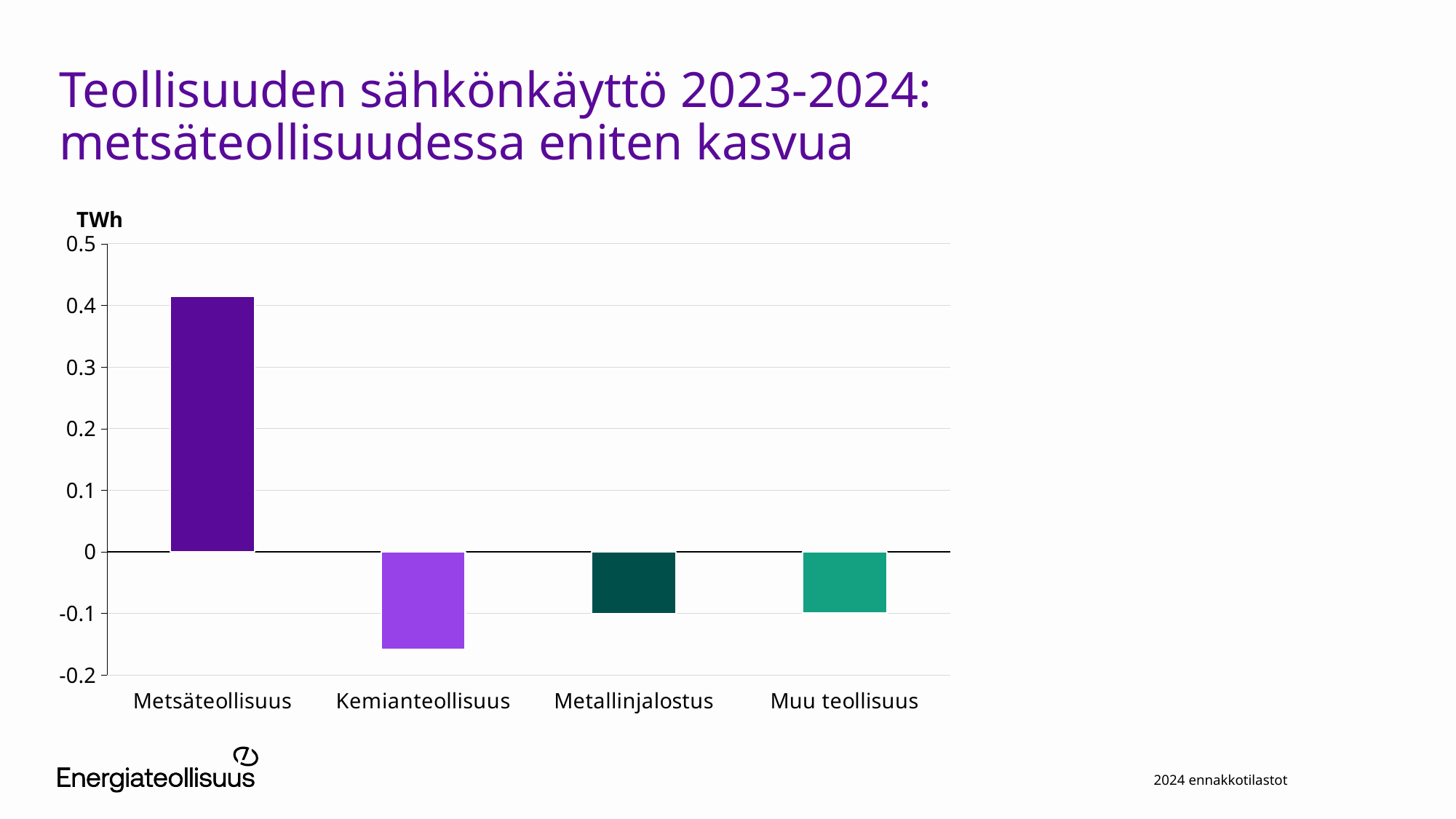
Is the value for Metsäteollisuus greater or less than 0.3? greater What unit is shown on the y axis of the chart? TWh Is the value for Kemianteollisuus greater or less than -0.1? less What kind of chart is shown on the slide? bar chart How many industry categories are shown on the x axis of the chart? 4 Which category has the highest value in the chart? Metsäteollisuus Is the value for Muu teollisuus greater or less than 0? less How many categories in the chart have a positive value? 1 Which has the larger value, Metsäteollisuus or Kemianteollisuus? Metsäteollisuus What is the title of the slide containing the chart? Teollisuuden sähkönkäyttö 2023-2024: metsäteollisuudessa eniten kasvua Which category has the lowest value in the chart? Kemianteollisuus